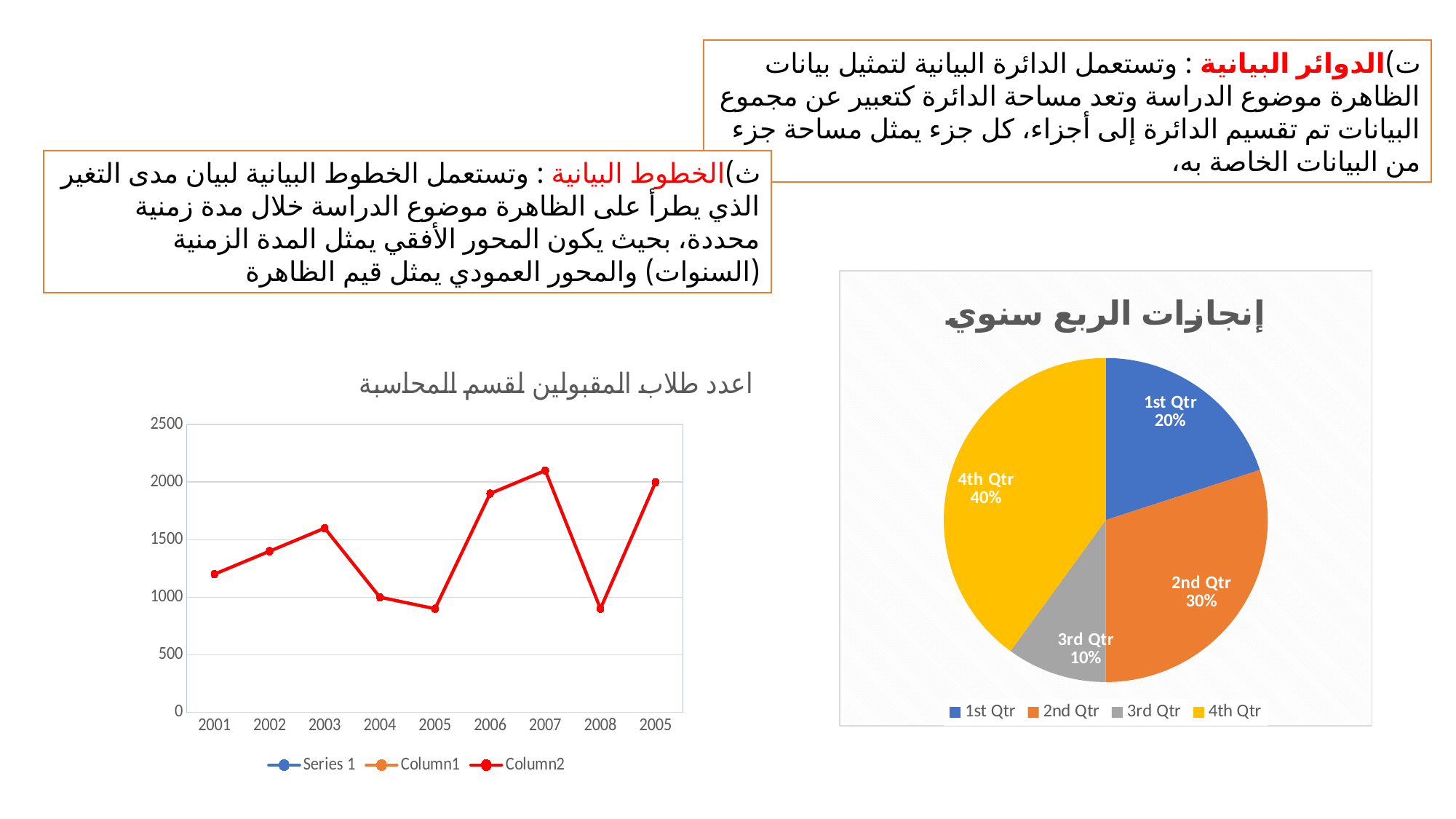
In the line chart titled اعدد طلاب المقبولين لقسم المحاسبة, do the values rise or fall from 2001 to 2003? rise What kind of chart is the chart on the left of the slide, titled اعدد طلاب المقبولين لقسم المحاسبة? line chart In the pie chart titled إنجازات الربع سنوي, how many slices does the pie have? 4 In the line chart titled اعدد طلاب المقبولين لقسم المحاسبة, is the value for 2007 greater or less than 2000? greater In the line chart titled اعدد طلاب المقبولين لقسم المحاسبة, how many series does the legend list? 3 In the line chart titled اعدد طلاب المقبولين لقسم المحاسبة, how many points are plotted along the x axis? 9 In the line chart titled اعدد طلاب المقبولين لقسم المحاسبة, is the value for 2008 greater or less than 1000? less In the pie chart titled إنجازات الربع سنوي, what is the difference in percentage points between 4th Qtr and 1st Qtr? 20% In the pie chart titled إنجازات الربع سنوي, which quarter has the largest slice? 4th Qtr In the pie chart titled إنجازات الربع سنوي, which quarter has the smallest slice? 3rd Qtr In the pie chart titled إنجازات الربع سنوي, what percentage is shown for 2nd Qtr? 30% In the pie chart titled إنجازات الربع سنوي, which is larger, 1st Qtr or 3rd Qtr? 1st Qtr